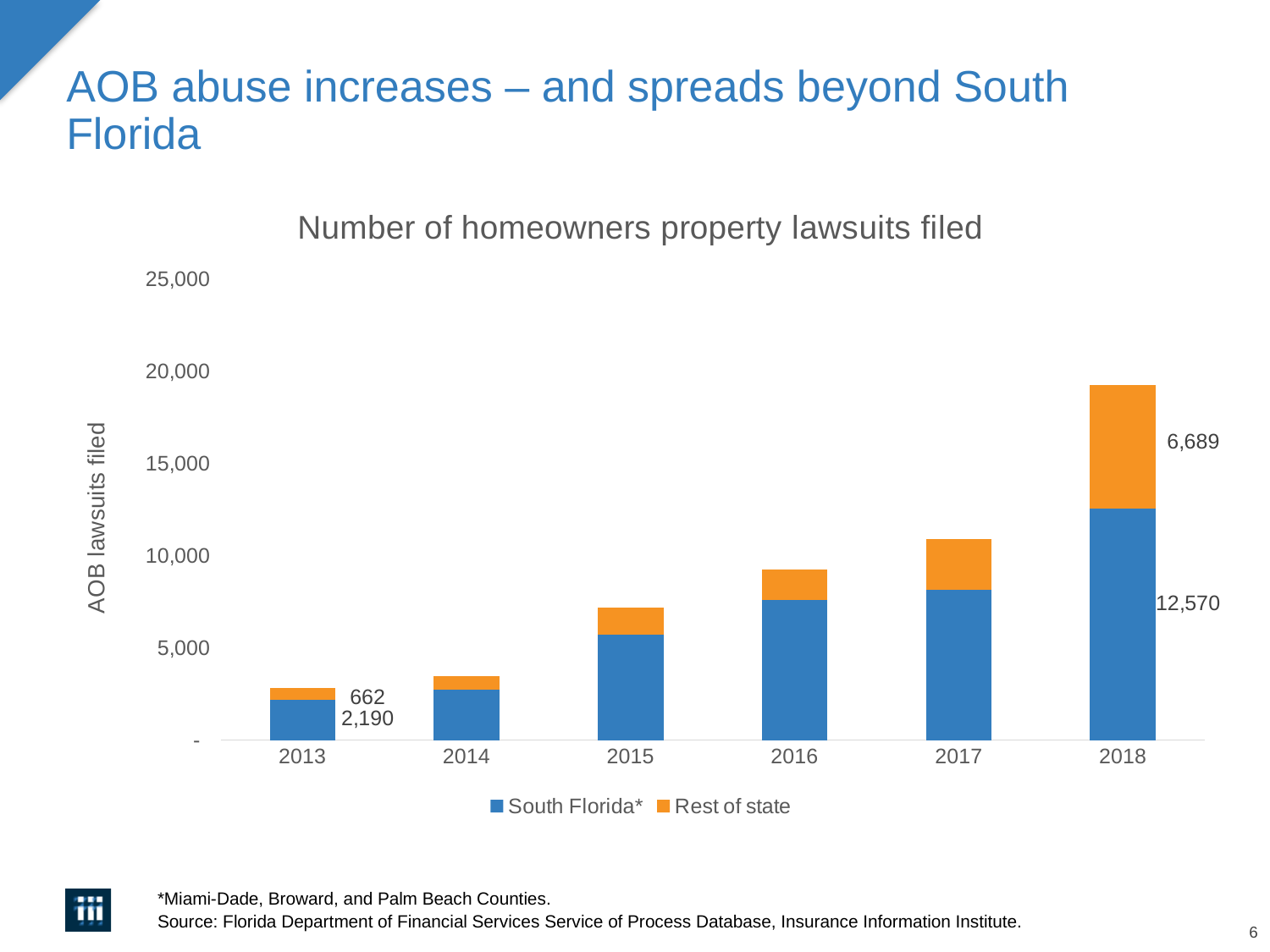
What is the difference between the South Florida* value in 2018 and the South Florida* value in 2013? 10,380 What is the value for Rest of state in 2013? 662 What is the total of the stacked bar for 2018? 19,259 What type of chart is shown on the slide? Stacked bar chart Which year has the highest total number of lawsuits filed? 2018 What is the value for Rest of state in 2018? 6,689 What is the value for South Florida* in 2013? 2,190 What is the title of the chart? Number of homeowners property lawsuits filed Is the total value for 2016 greater or less than 10,000? less Which year has the lowest total number of lawsuits filed? 2013 How many series does the legend list? 2 What is the value for South Florida* in 2018? 12,570